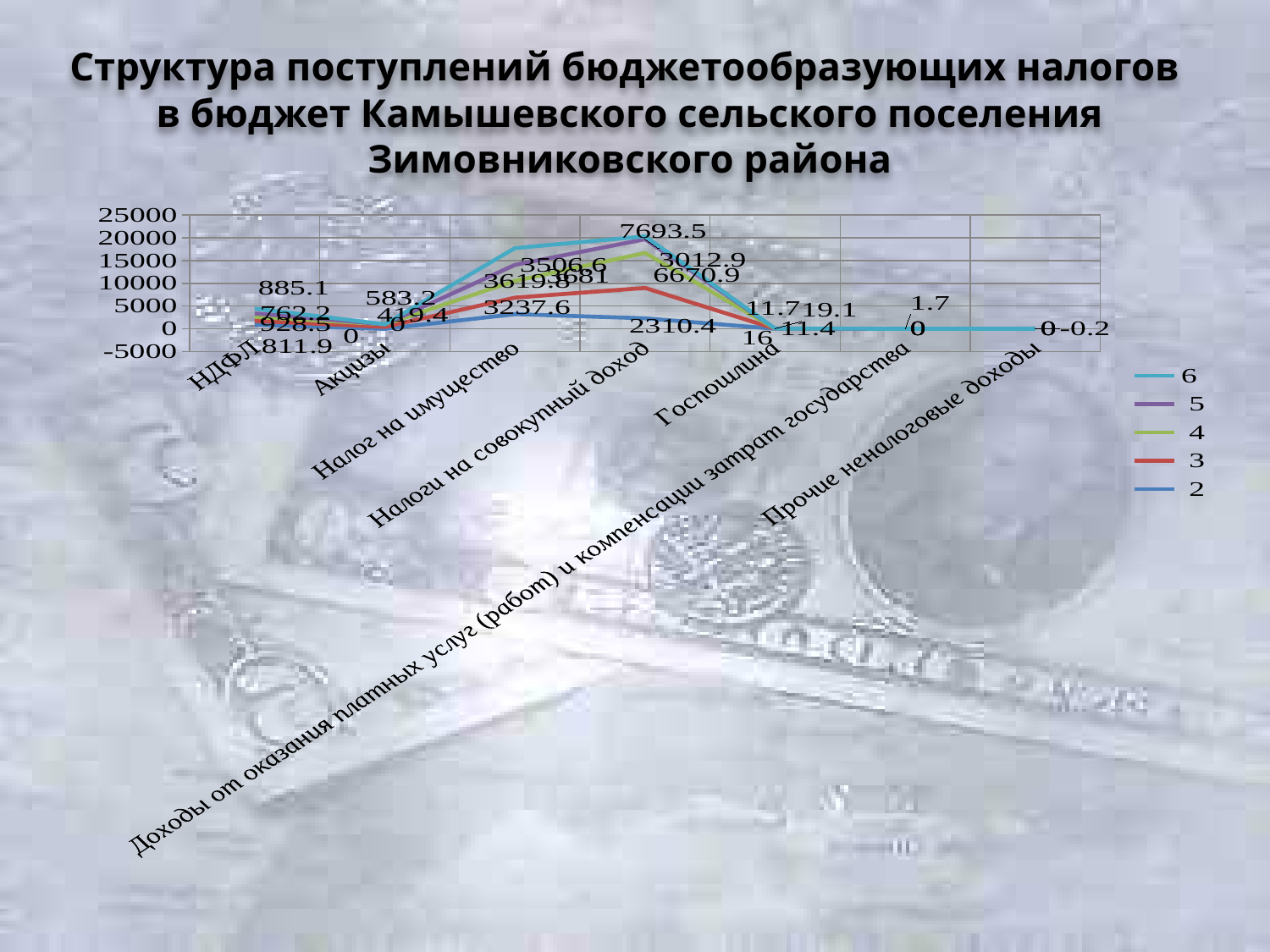
How many series does the legend list? 5 Is the value for series 2 at Налог на имущество greater or less than 5000? less Do the values of series 6 rise or fall from Налоги на совокупный доход to Госпошлина? fall Which is larger for series 6: the value at Налоги на совокупный доход or the value at Госпошлина? Налоги на совокупный доход How many categories are shown along the x axis? 7 Which series names are listed in the legend? 6, 5, 4, 3, 2 What is the title of the chart on the slide? Структура поступлений бюджетообразующих налогов в бюджет Камышевского сельского поселения Зимовниковского района For which category does series 6 reach its highest point? Налоги на совокупный доход Do the values of series 6 rise or fall from Акцизы to Налог на имущество? rise What kind of chart is shown on the slide? line chart